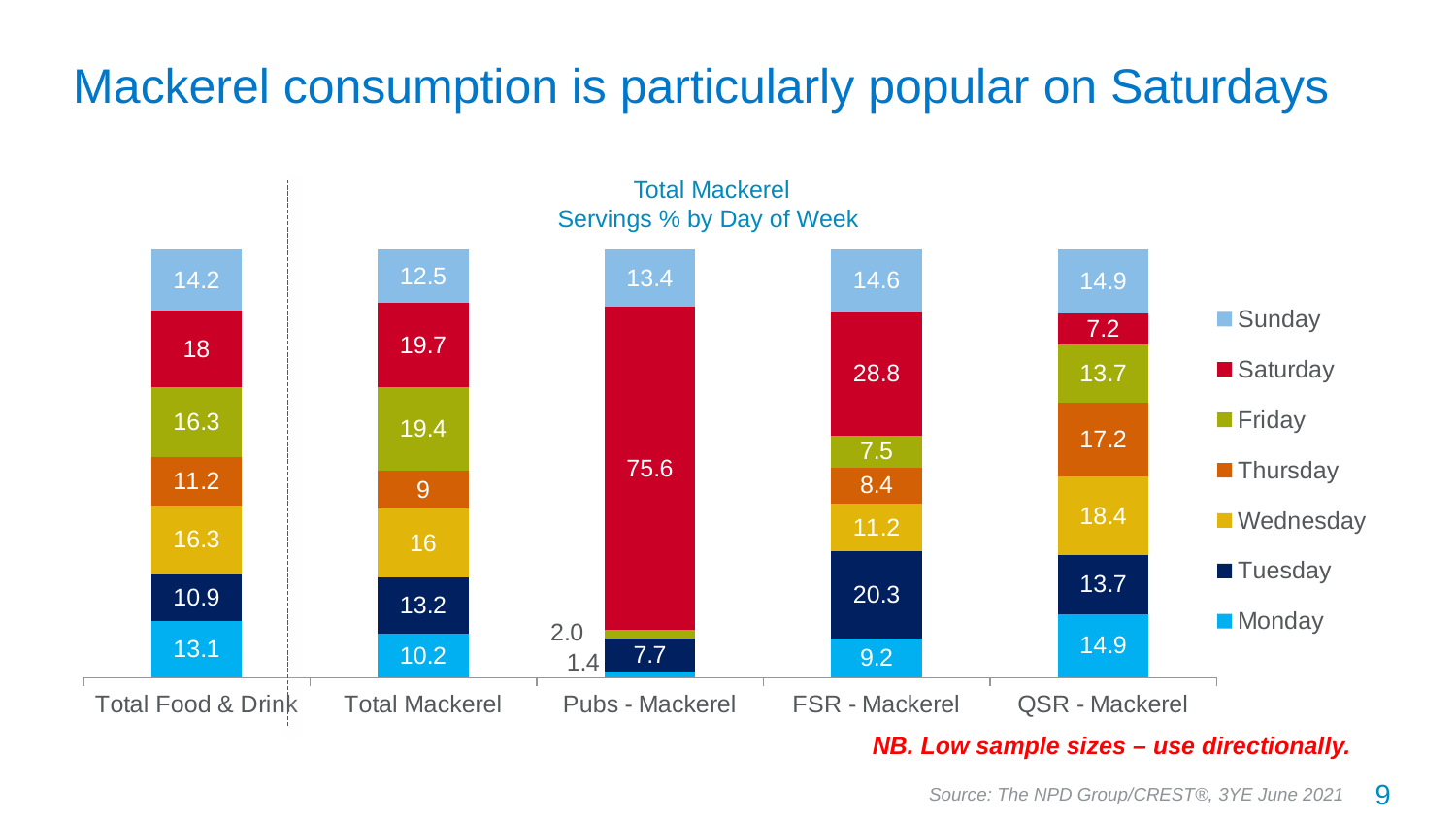
What is the Monday value for Total Mackerel? 10.2 What is the difference between the Saturday values for FSR - Mackerel and QSR - Mackerel? 21.6 How many series does the legend list? 7 Which category has the lowest Saturday value? QSR - Mackerel Which has the larger Friday value, Total Mackerel or Total Food & Drink? Total Mackerel What is the Wednesday value for QSR - Mackerel? 18.4 How many categories are shown on the x axis? 5 Which category has the highest Saturday value? Pubs - Mackerel What is the title of the chart? Total Mackerel Servings % by Day of Week What is the Saturday value for Pubs - Mackerel? 75.6 What kind of chart is shown on the slide? Stacked bar chart What is the Tuesday value for FSR - Mackerel? 20.3